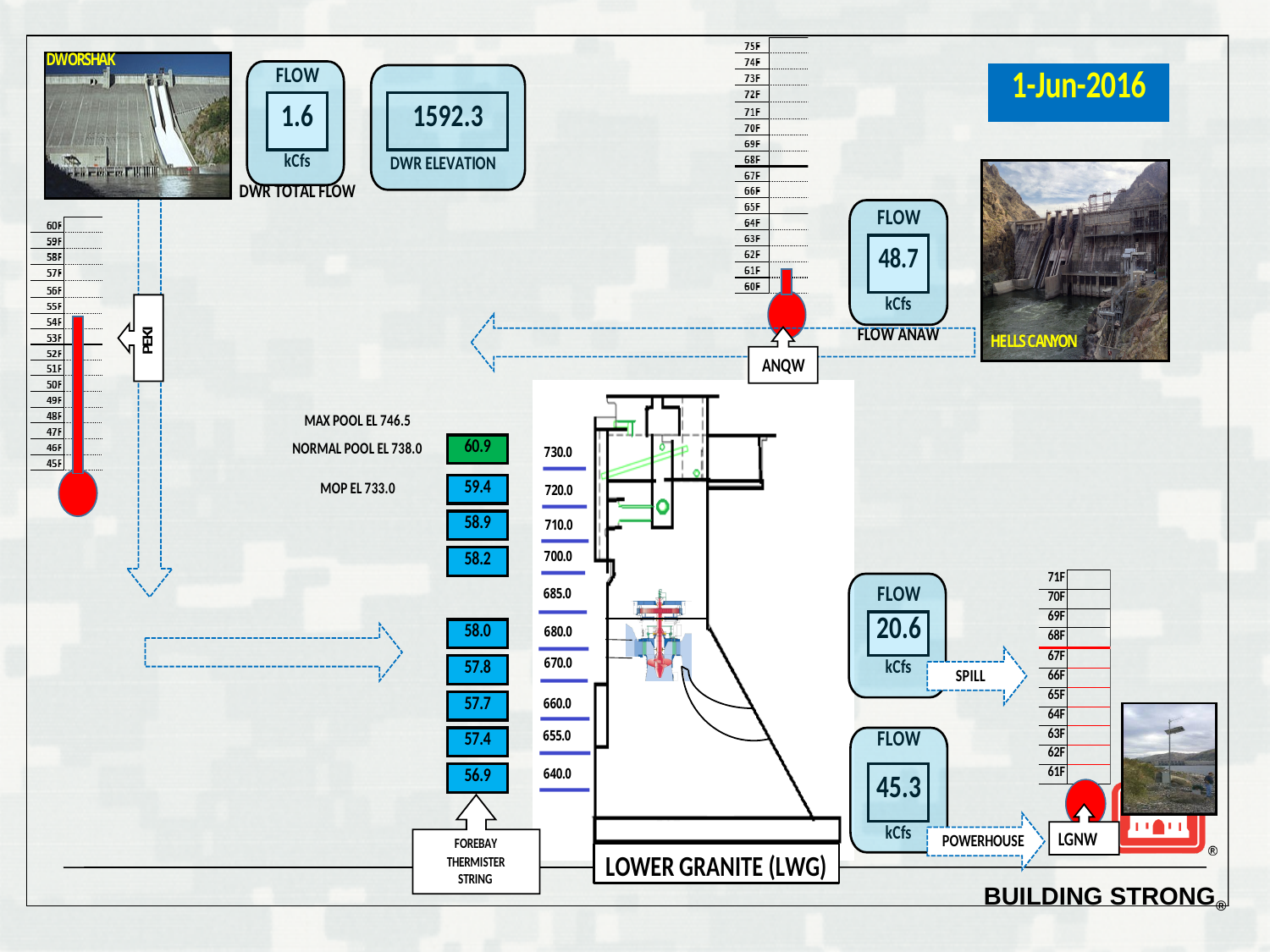
What is the POWERHOUSE flow value shown for Lower Granite? 45.3 kCfs What is the difference between the POWERHOUSE flow (45.3 kCfs) and the SPILL flow (20.6 kCfs)? 24.7 kCfs What date is shown in the blue box at the top right of the slide? 1-Jun-2016 What is the highest reading shown in the forebay thermistor string? 60.9 What is the DWR total flow value shown in the flow box next to the Dworshak photo? 1.6 kCfs What is the lowest reading shown in the forebay thermistor string? 56.9 What is the flow value shown in the FLOW box labelled FLOW ANAW near the Hells Canyon photo? 48.7 kCfs How many temperature readings are shown in the forebay thermistor string column? 9 Which is larger at Lower Granite, the SPILL flow or the POWERHOUSE flow? POWERHOUSE Do the forebay thermistor string readings increase or decrease going from the top of the column to the bottom? decrease What DWR elevation value is shown on the slide? 1592.3 What is the SPILL flow value shown for Lower Granite? 20.6 kCfs